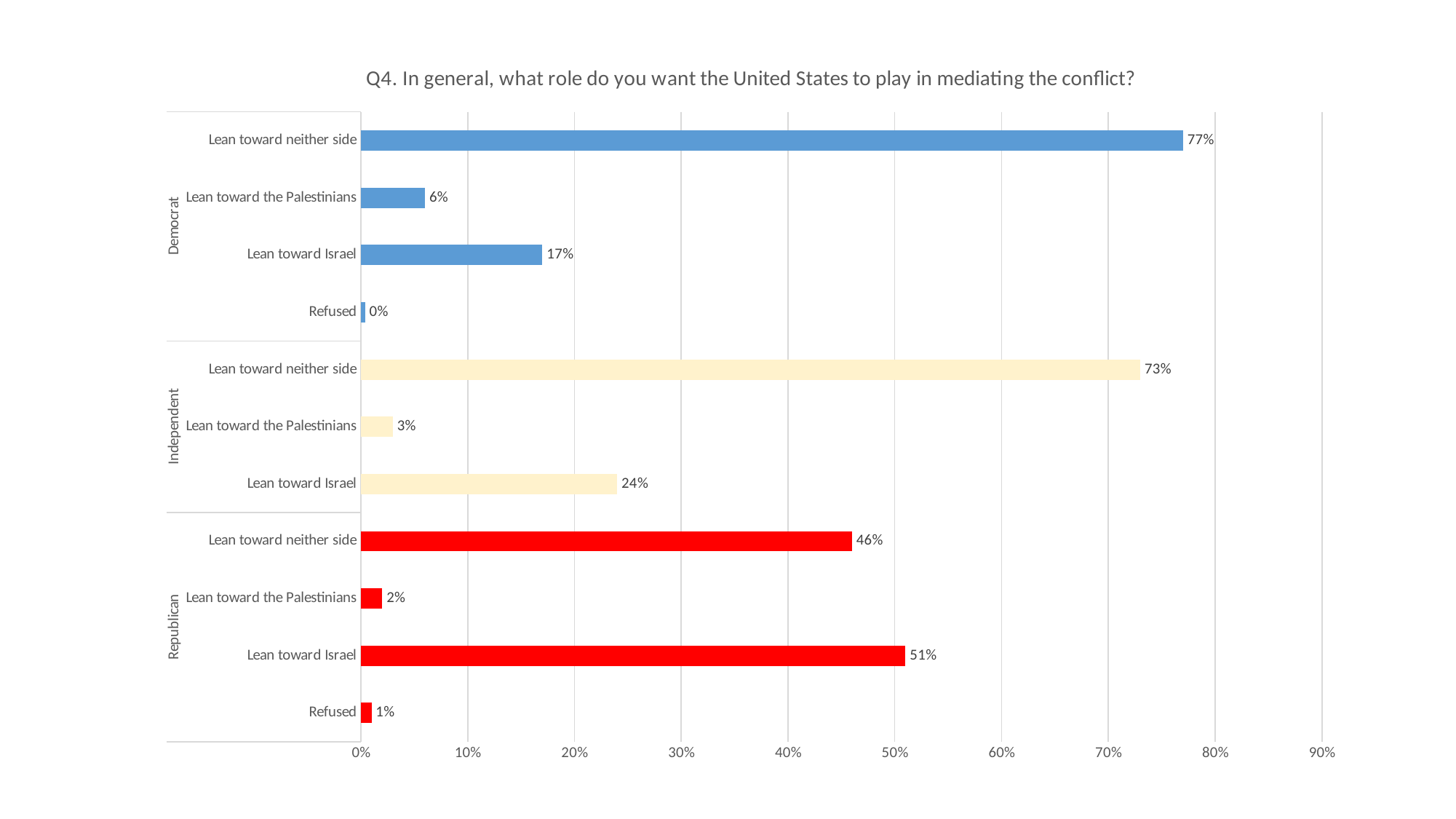
What kind of chart is shown on the slide? Bar chart Which response has the lowest value among Democrats? Refused What percentage of Independents want the United States to lean toward the Palestinians? 3% What percentage of Democrats want the United States to lean toward neither side? 77% Which response has the highest value among Republicans? Lean toward Israel Which is larger: the Independent value for 'Lean toward Israel' or the Democrat value for 'Lean toward Israel'? Independent What percentage of Republicans want the United States to lean toward Israel? 51% Is the Independent value for 'Lean toward neither side' greater or less than 70%? greater What colour are the bars for the Republican group? Red How many bars are plotted in the chart? 11 What is the title of the chart? Q4. In general, what role do you want the United States to play in mediating the conflict? What is the difference between the Democrat and Republican values for 'Lean toward neither side'? 31%